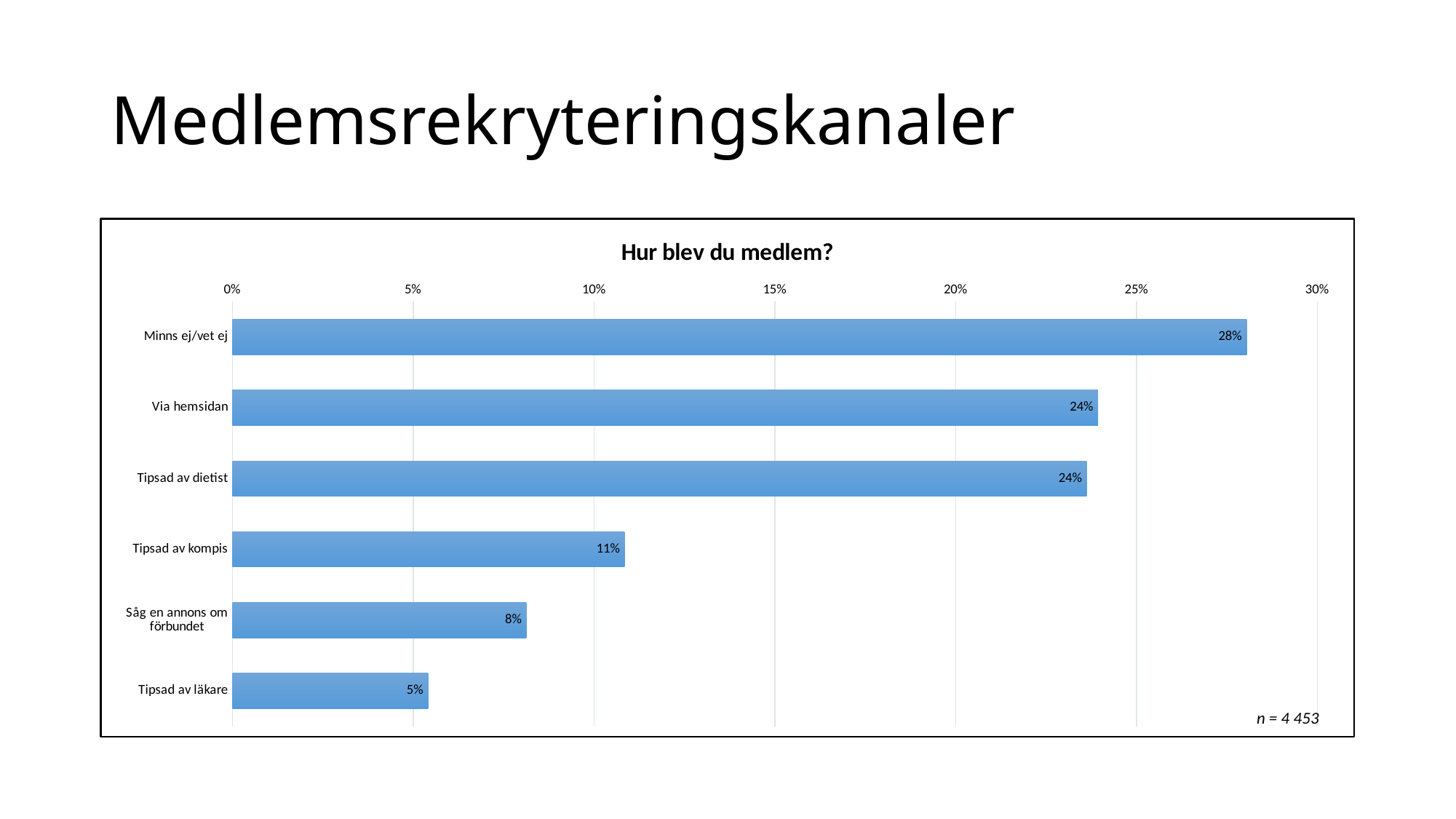
What is the value for Tipsad av kompis? 11% What is the difference between the values for Minns ej/vet ej and Tipsad av kompis? 17% What kind of chart is shown on the slide? bar chart What is the title of the chart? Hur blev du medlem? What is the value for Tipsad av läkare? 5% Which category has the highest value? Minns ej/vet ej Which category has the lowest value? Tipsad av läkare Is the value for Via hemsidan greater or less than 20%? greater Which is larger, the value for Tipsad av kompis or the value for Såg en annons om förbundet? Tipsad av kompis How many categories are shown in the chart? 6 What is the value for Minns ej/vet ej? 28% What is the value for Såg en annons om förbundet? 8%